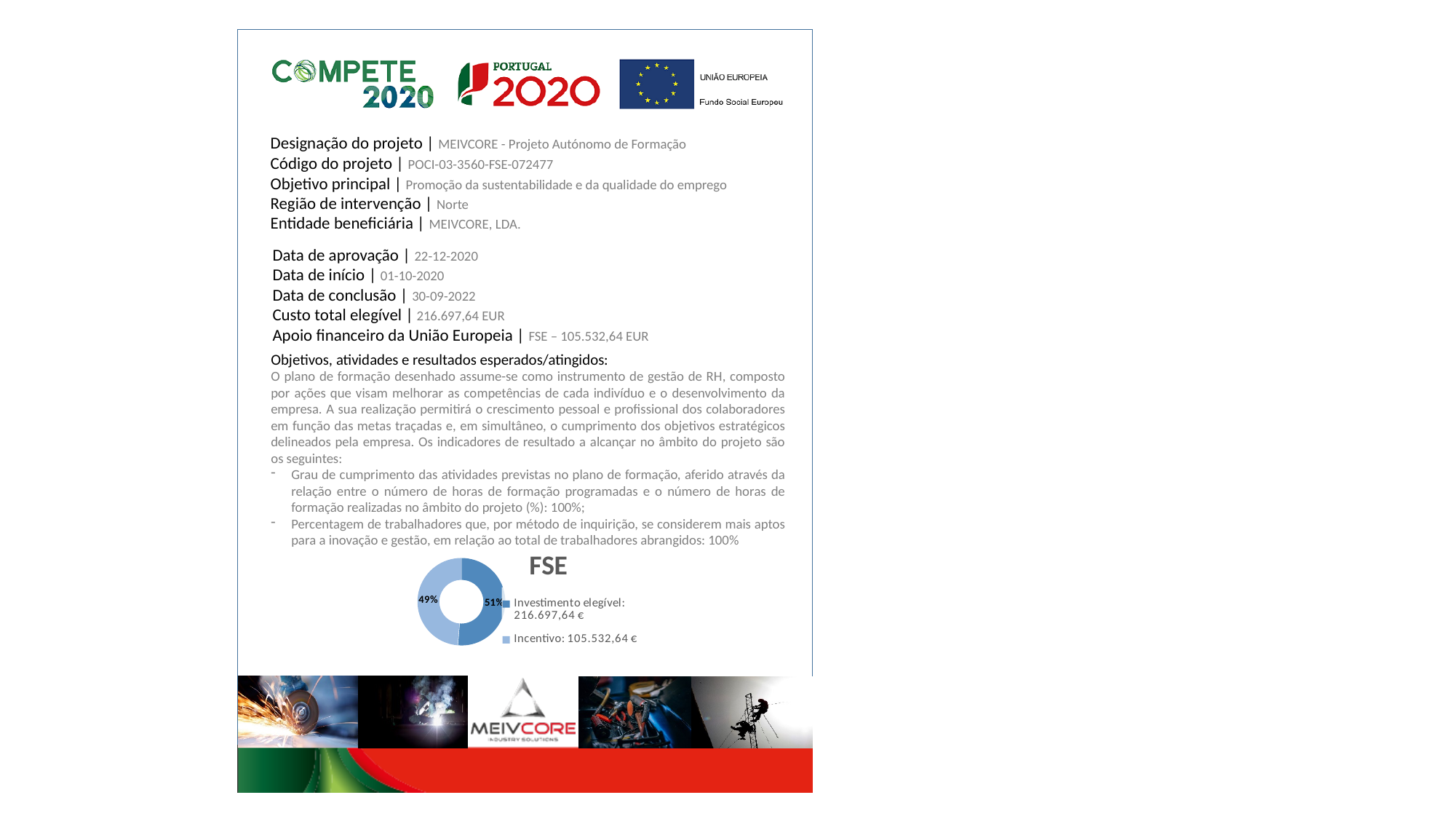
What is the title of the chart on the slide? FSE How many slices does the FSE chart have? 2 How many entries does the legend of the FSE chart list? 2 Which slice of the FSE chart has the larger percentage? Investimento elegível What share of the FSE chart is labelled for Incentivo? 49% What share of the FSE chart is labelled for Investimento elegível? 51% What kind of chart is shown on the slide? Doughnut chart What amount is shown in the legend for Incentivo? 105.532,64 € What is the difference between the two percentages shown on the FSE chart? 2% Is the percentage for Investimento elegível larger or smaller than the percentage for Incentivo? Larger Which slice of the FSE chart has the smaller percentage? Incentivo What amount is shown in the legend for Investimento elegível? 216.697,64 €